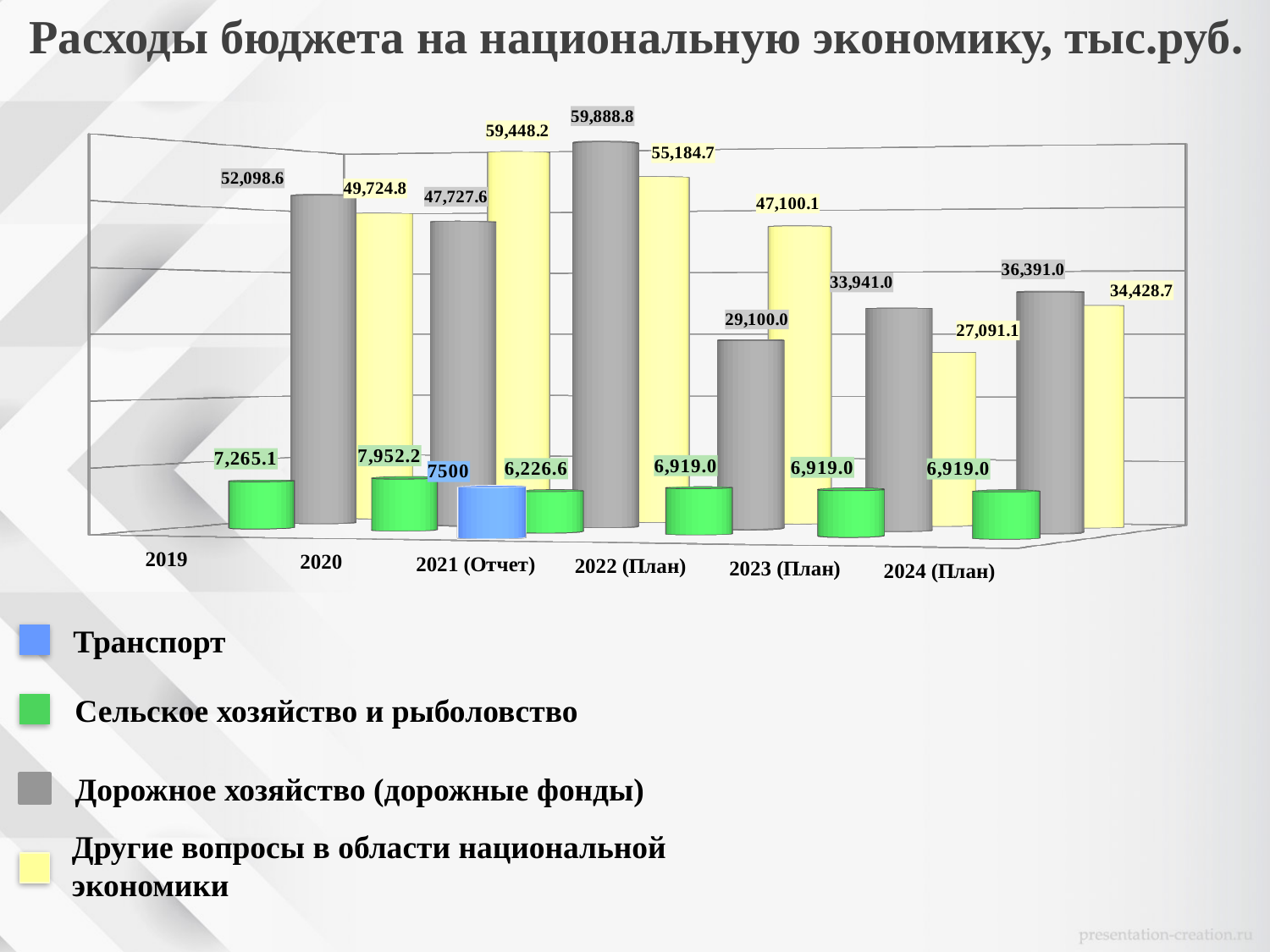
How many series does the legend list? 4 What is the value for Другие вопросы в области национальной экономики in 2020? 59,448.2 In which year is the value for Другие вопросы в области национальной экономики lowest? 2023 (План) What is the value for Дорожное хозяйство (дорожные фонды) in 2019? 52,098.6 What is the difference between Дорожное хозяйство (дорожные фонды) and Другие вопросы в области национальной экономики in 2022 (План)? 18,000.1 What is the value for Сельское хозяйство и рыболовство in 2022 (План)? 6,919.0 How many years are shown on the x axis? 6 Which is larger in 2024 (План): Дорожное хозяйство (дорожные фонды) or Другие вопросы в области национальной экономики? Дорожное хозяйство (дорожные фонды) In which year is the value for Дорожное хозяйство (дорожные фонды) highest? 2021 (Отчет) What is the value for Транспорт in 2021 (Отчет)? 7500 What kind of chart is shown on the slide? Bar chart Which series is shown in blue in the legend? Транспорт